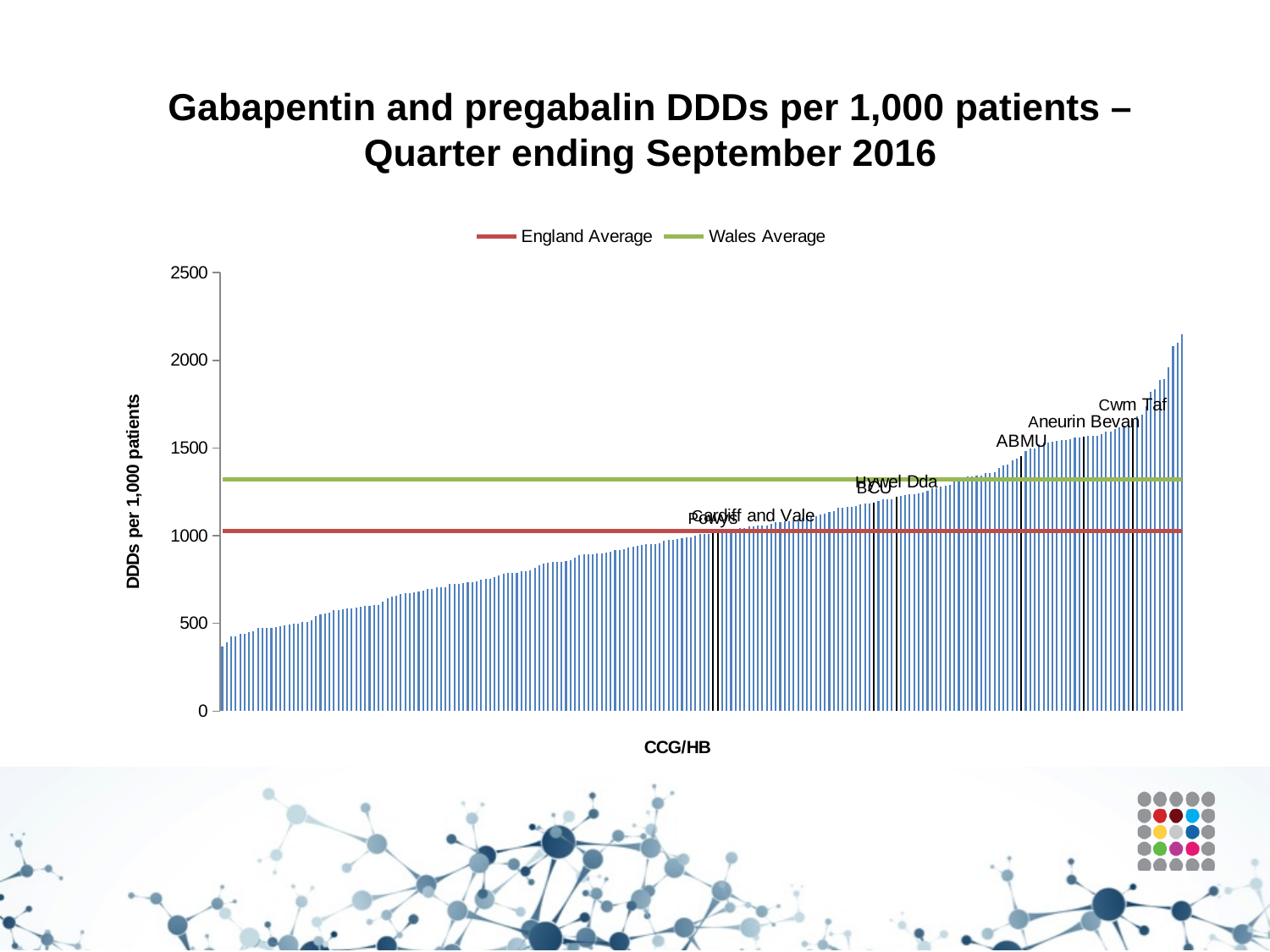
Is the Wales Average line greater or less than 1000? greater Is the value for Hywel Dda greater or less than 1500? less Which is higher, the Wales Average line or the England Average line? Wales Average What is the label on the y axis? DDDs per 1,000 patients Is the England Average line greater or less than 1500? less How many series does the legend list? 2 Do the bar values rise or fall from left to right along the x axis? rise Which has the higher value, Cwm Taf or Powys? Cwm Taf What kind of chart is shown on the slide? bar chart